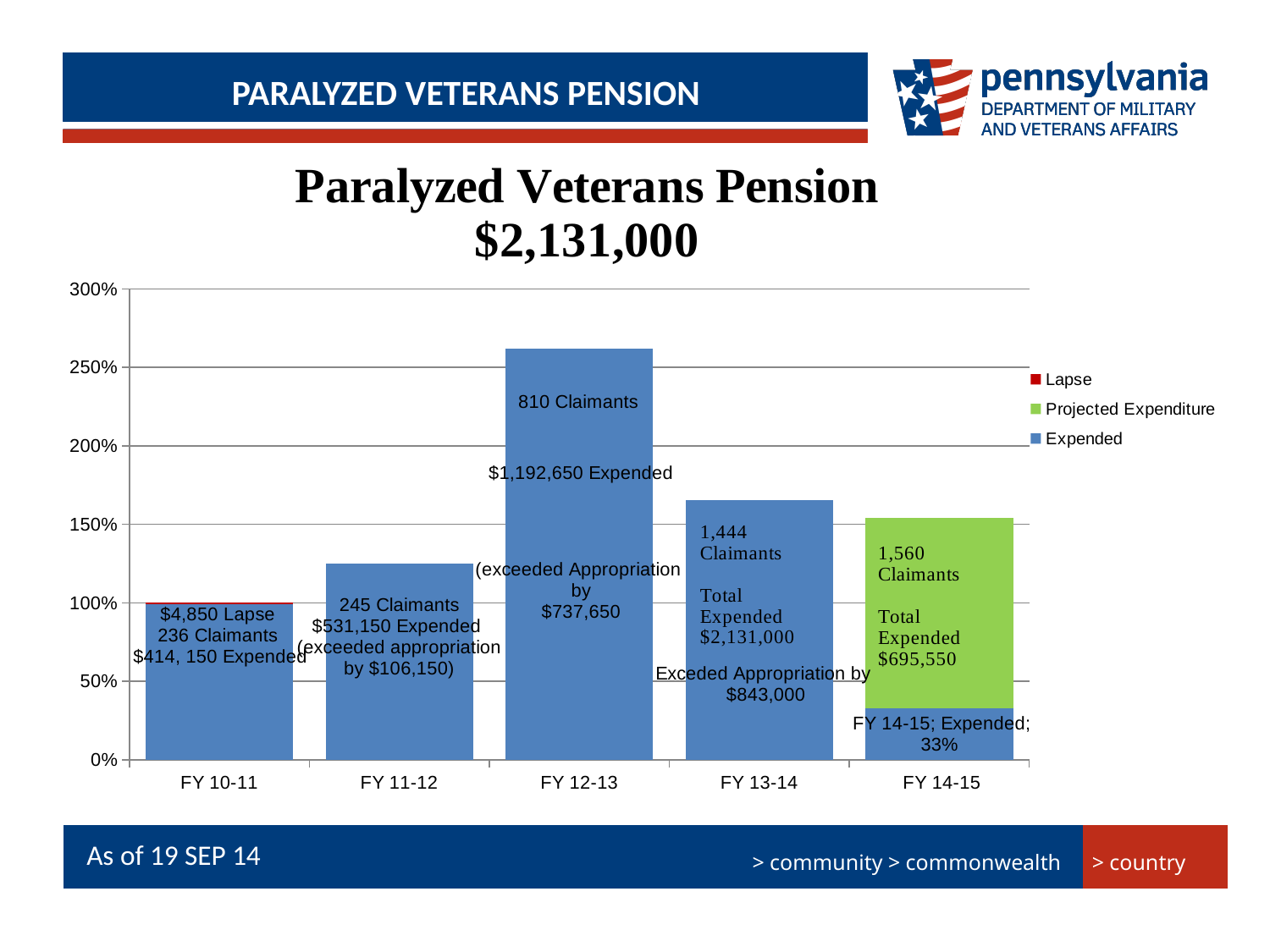
Is the bar for FY 11-12 greater or less than 100%? greater Which fiscal year has the shortest bar? FY 10-11 How many fiscal years are shown on the x axis of the chart? 5 What is the lapse amount labelled for FY 10-11? $4,850 What percentage is labelled for Expended in FY 14-15? 33% How many series does the chart legend list? 3 How many claimants are labelled for FY 12-13? 810 Claimants Which fiscal year has the tallest bar? FY 12-13 What amount was expended in FY 11-12 according to the bar label? $531,150 Is the bar for FY 12-13 greater or less than 250%? greater Which colour represents Projected Expenditure in the legend? green What kind of chart is shown on the slide? bar chart